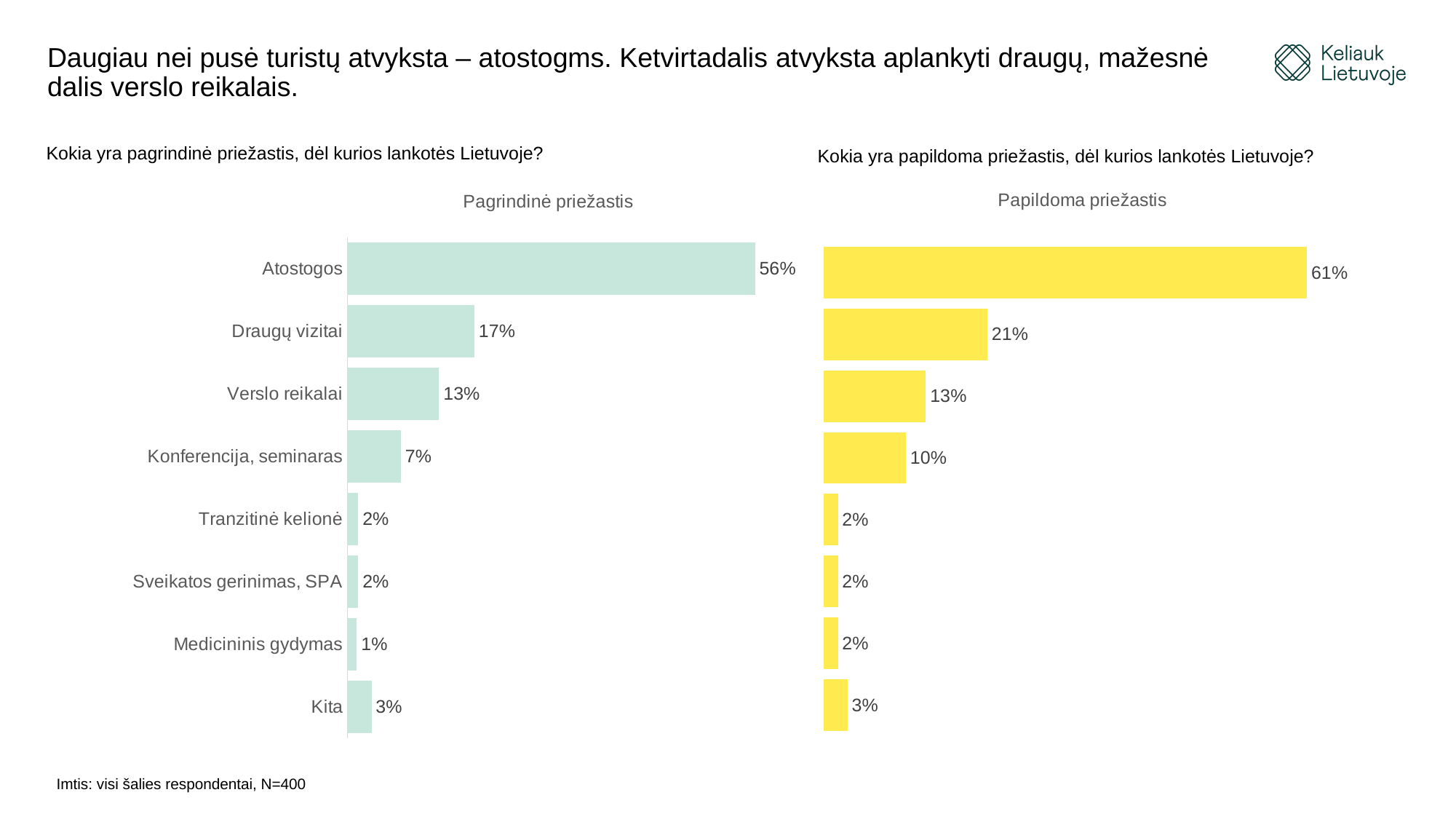
What colour are the bars in the 'Papildoma priežastis' chart? Yellow In the 'Pagrindinė priežastis' chart, which category has the highest value? Atostogos In the 'Pagrindinė priežastis' chart, what is the value for Atostogos? 56% What kind of chart is the 'Papildoma priežastis' chart? Bar chart Which is larger: Konferencija, seminaras in the 'Pagrindinė priežastis' chart or Konferencija, seminaras in the 'Papildoma priežastis' chart? Papildoma priežastis In the 'Pagrindinė priežastis' chart, which category has the lowest value? Medicininis gydymas In the 'Papildoma priežastis' chart, what is the value for Draugų vizitai? 21% In the 'Pagrindinė priežastis' chart, what is the value for Konferencija, seminaras? 7% How many categories does the 'Pagrindinė priežastis' chart show? 8 In the 'Pagrindinė priežastis' chart, what is the difference between Draugų vizitai and Verslo reikalai? 4% In the 'Papildoma priežastis' chart, what is the difference between Atostogos and Draugų vizitai? 40% In the 'Papildoma priežastis' chart, what is the value for Medicininis gydymas? 2%